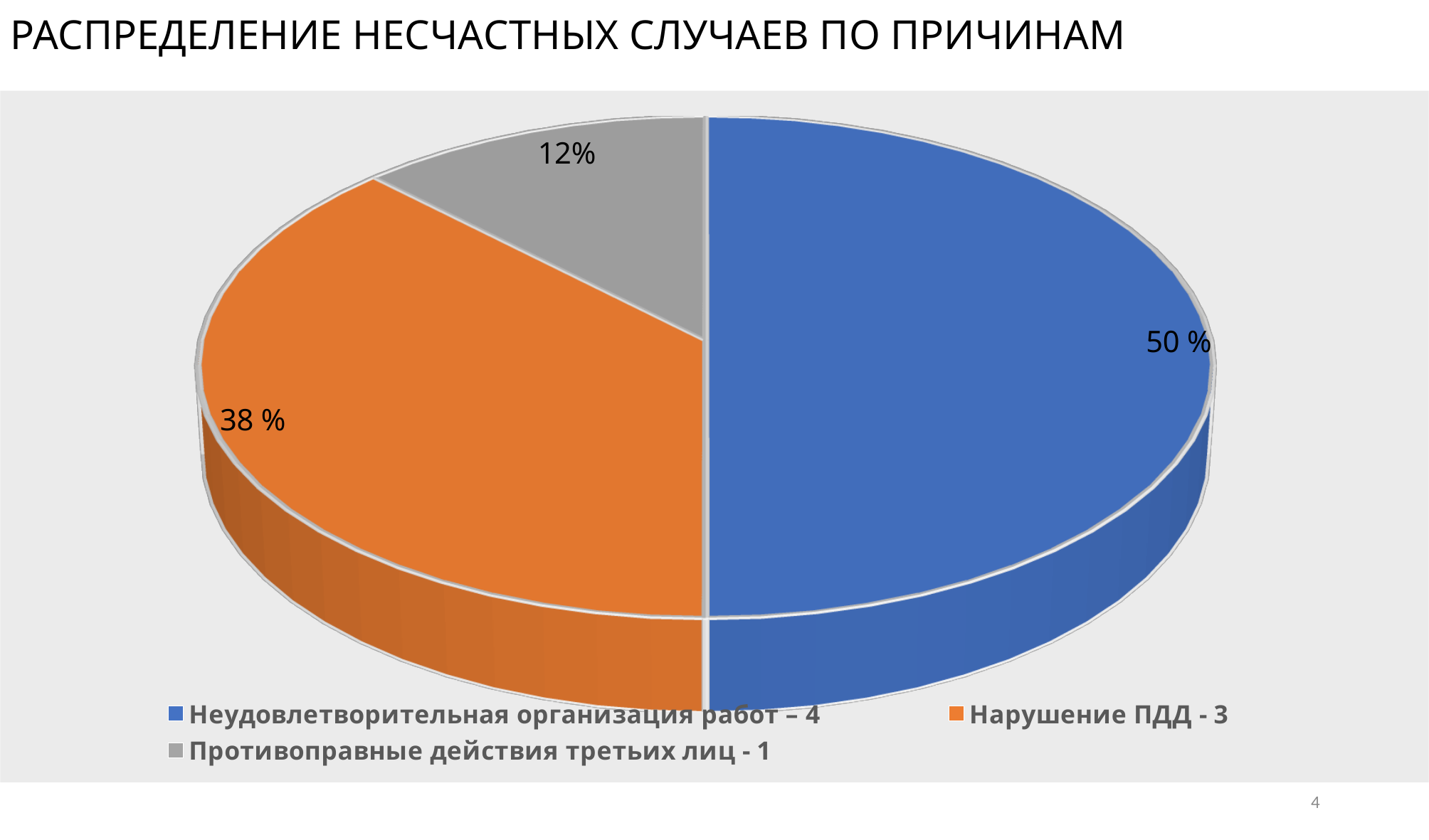
What is the title of the slide? РАСПРЕДЕЛЕНИЕ НЕСЧАСТНЫХ СЛУЧАЕВ ПО ПРИЧИНАМ How many entries does the legend list? 3 How many slices does the pie chart have? 3 Which category has the smallest slice of the pie? Противоправные действия третьих лиц - 1 What share of the pie does the slice for Нарушение ПДД - 3 represent? 38 % What share of the pie does the slice for Противоправные действия третьих лиц - 1 represent? 12% What is the difference in percentage points between the slice for Неудовлетворительная организация работ – 4 and the slice for Нарушение ПДД - 3? 12 What colour is the slice for Нарушение ПДД - 3? Orange Which slice is larger: Нарушение ПДД - 3 or Противоправные действия третьих лиц - 1? Нарушение ПДД - 3 What kind of chart is shown on the slide? Pie chart Which category has the largest slice of the pie? Неудовлетворительная организация работ – 4 What share of the pie does the slice for Неудовлетворительная организация работ – 4 represent? 50 %